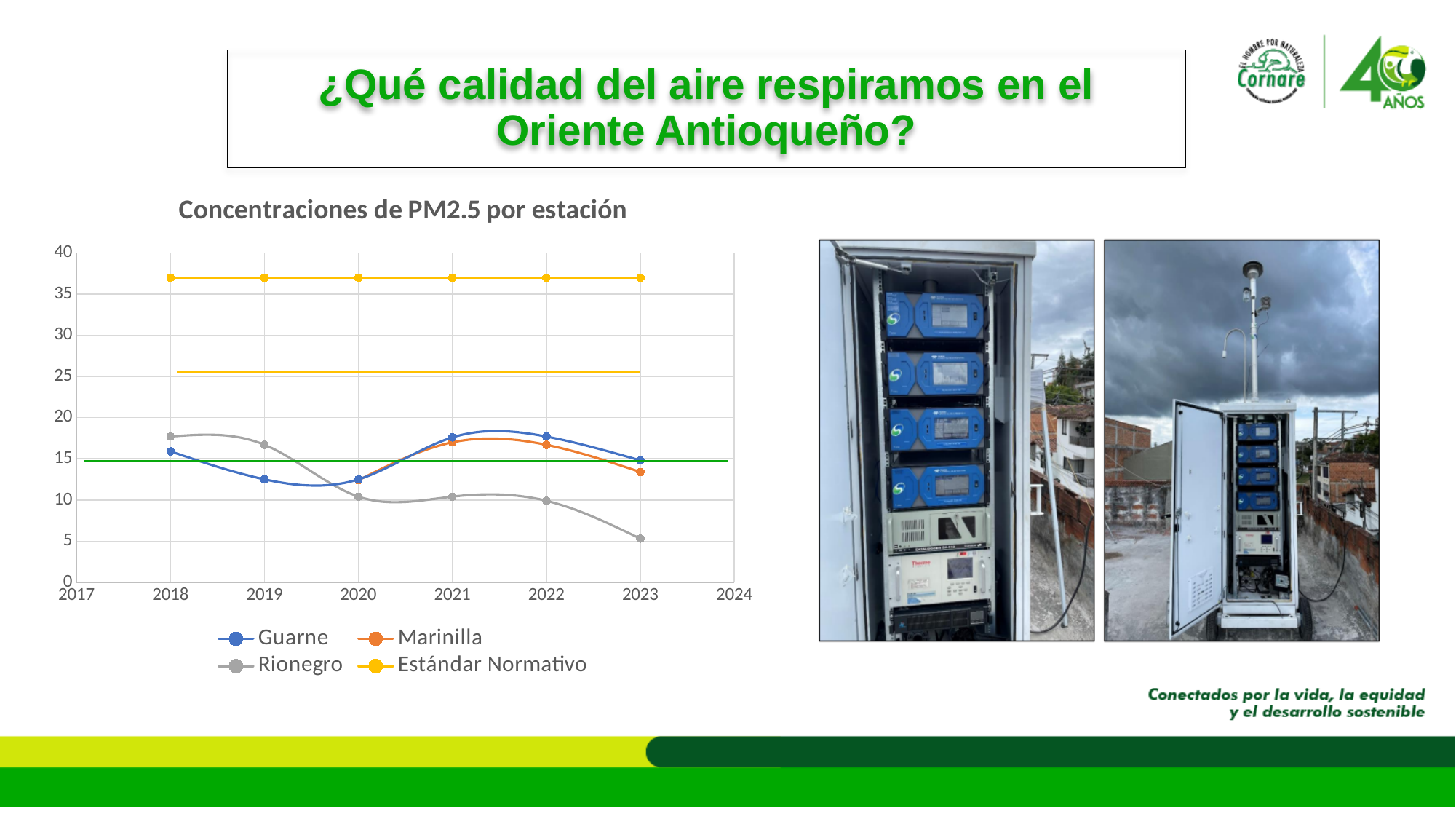
Is the value for Marinilla in 2023 greater or less than 15? less Does the Rionegro series rise or fall from 2018 to 2023? fall Which station has the lowest PM2.5 value in 2023? Rionegro In 2023, which is higher: Guarne or Marinilla? Guarne How many series does the legend of the chart list? 4 Is the value for Rionegro in 2023 greater or less than 10? less What is the title of the chart? Concentraciones de PM2.5 por estación How many years have data points plotted for the Guarne series? 6 What kind of chart is shown on the slide? line chart Is the value for Estándar Normativo in 2020 greater or less than 35? greater In 2018, which is higher: Rionegro or Guarne? Rionegro